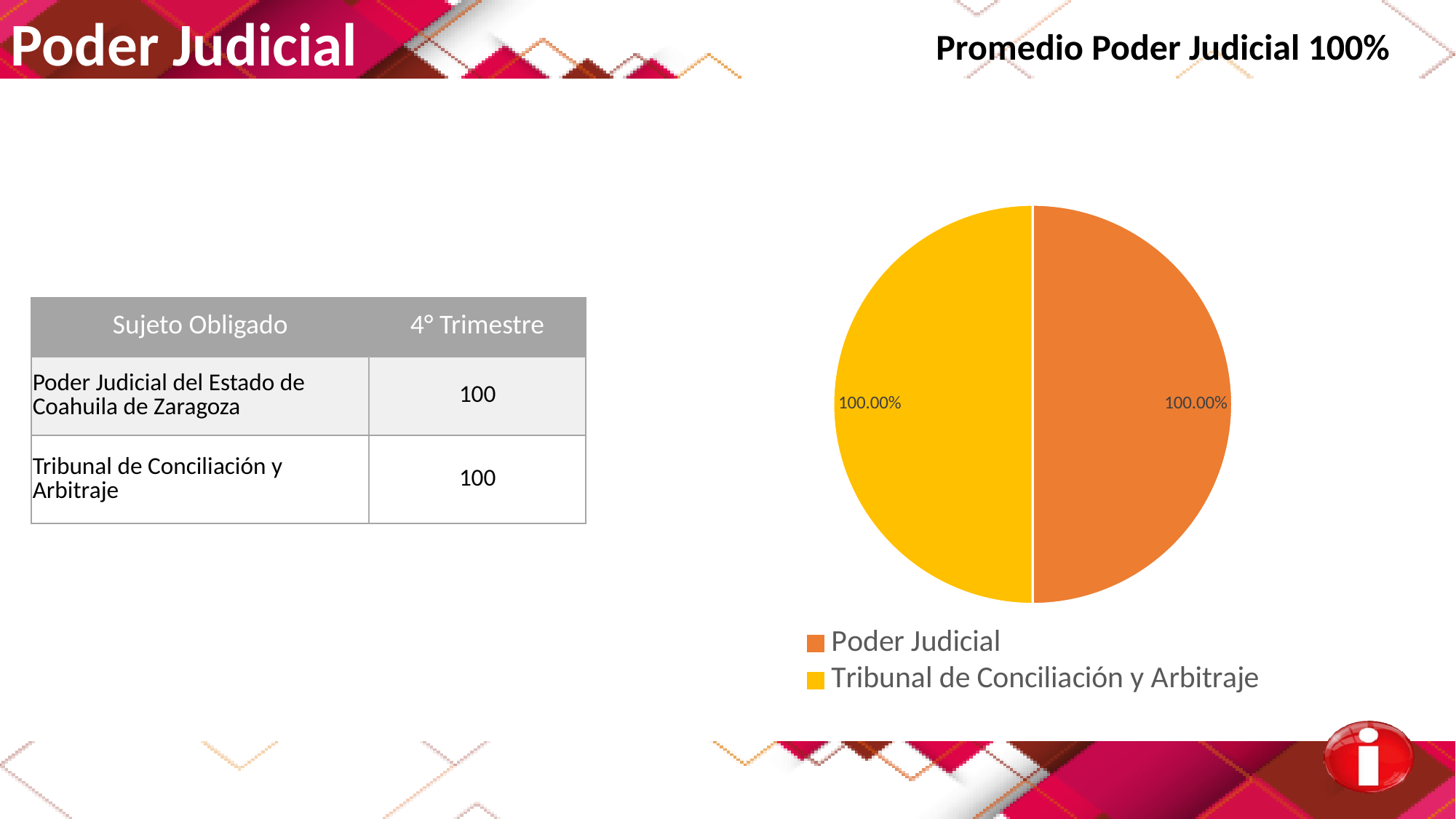
How many entries does the legend of the pie chart list? 2 Is the data label on the Poder Judicial slice greater or less than 50%? greater What is the difference between the data labels of the Poder Judicial slice and the Tribunal de Conciliación y Arbitraje slice? 0.00% What data label is shown on the Poder Judicial slice of the pie chart? 100.00% How many slices does the pie chart have? 2 Which colour represents Poder Judicial in the pie chart? orange What data label is shown on the Tribunal de Conciliación y Arbitraje slice of the pie chart? 100.00% Which legend entry is shown in yellow in the pie chart? Tribunal de Conciliación y Arbitraje What kind of chart is shown on the slide? pie chart